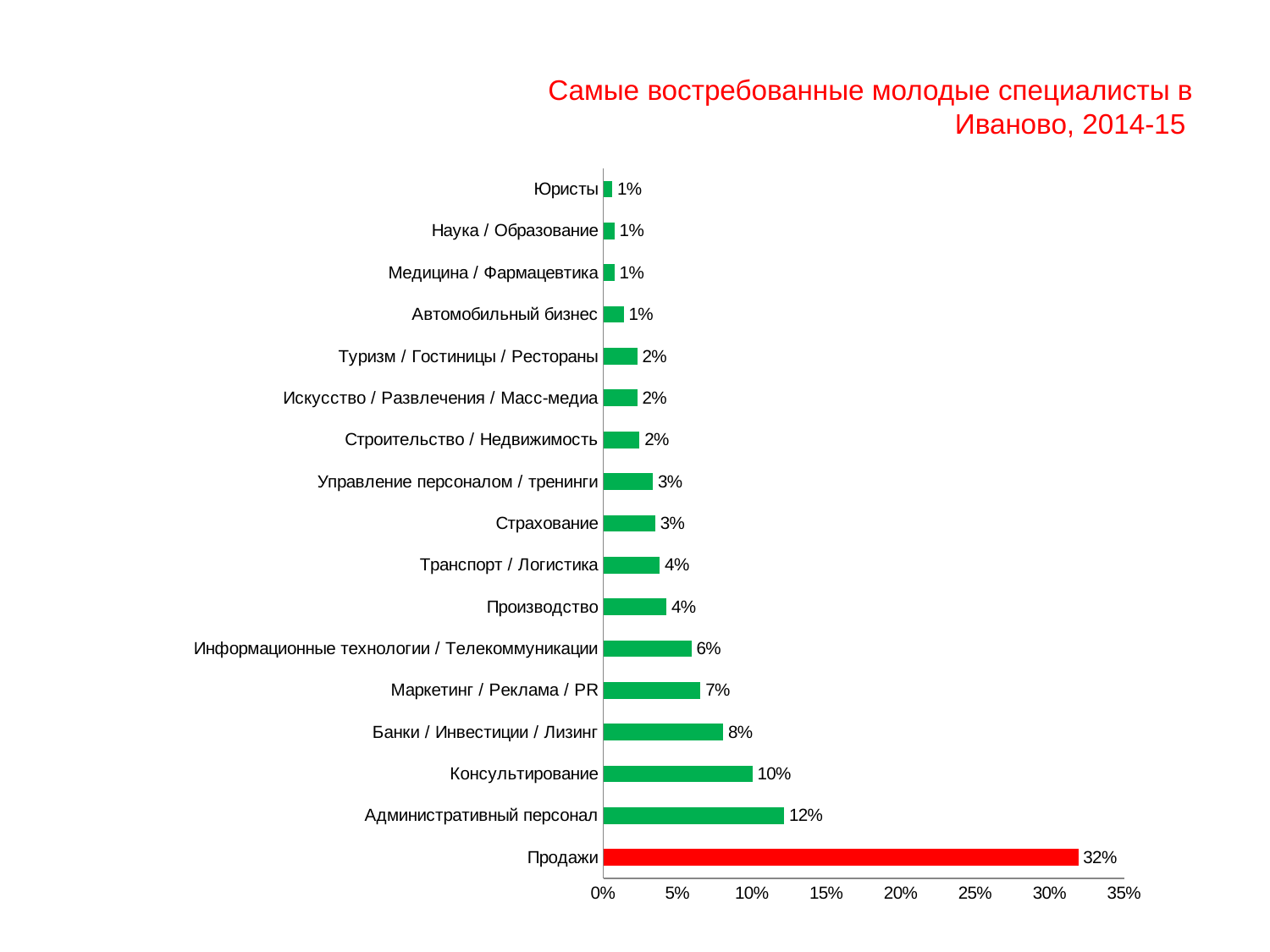
How many categories are shown in the chart? 17 Which category has the highest value? Продажи What is the difference between the values for Продажи and Административный персонал? 20% What is the value for Транспорт / Логистика? 4% What is the value for Банки / Инвестиции / Лизинг? 8% Is the value for Продажи greater or less than 30%? greater What is the value for Продажи? 32% What kind of chart is shown on the slide? bar chart What is the title of the chart? Самые востребованные молодые специалисты в Иваново, 2014-15 Which is larger, the value for Маркетинг / Реклама / PR or the value for Информационные технологии / Телекоммуникации? Маркетинг / Реклама / PR What is the value for Консультирование? 10% Which bar is coloured red rather than green? Продажи